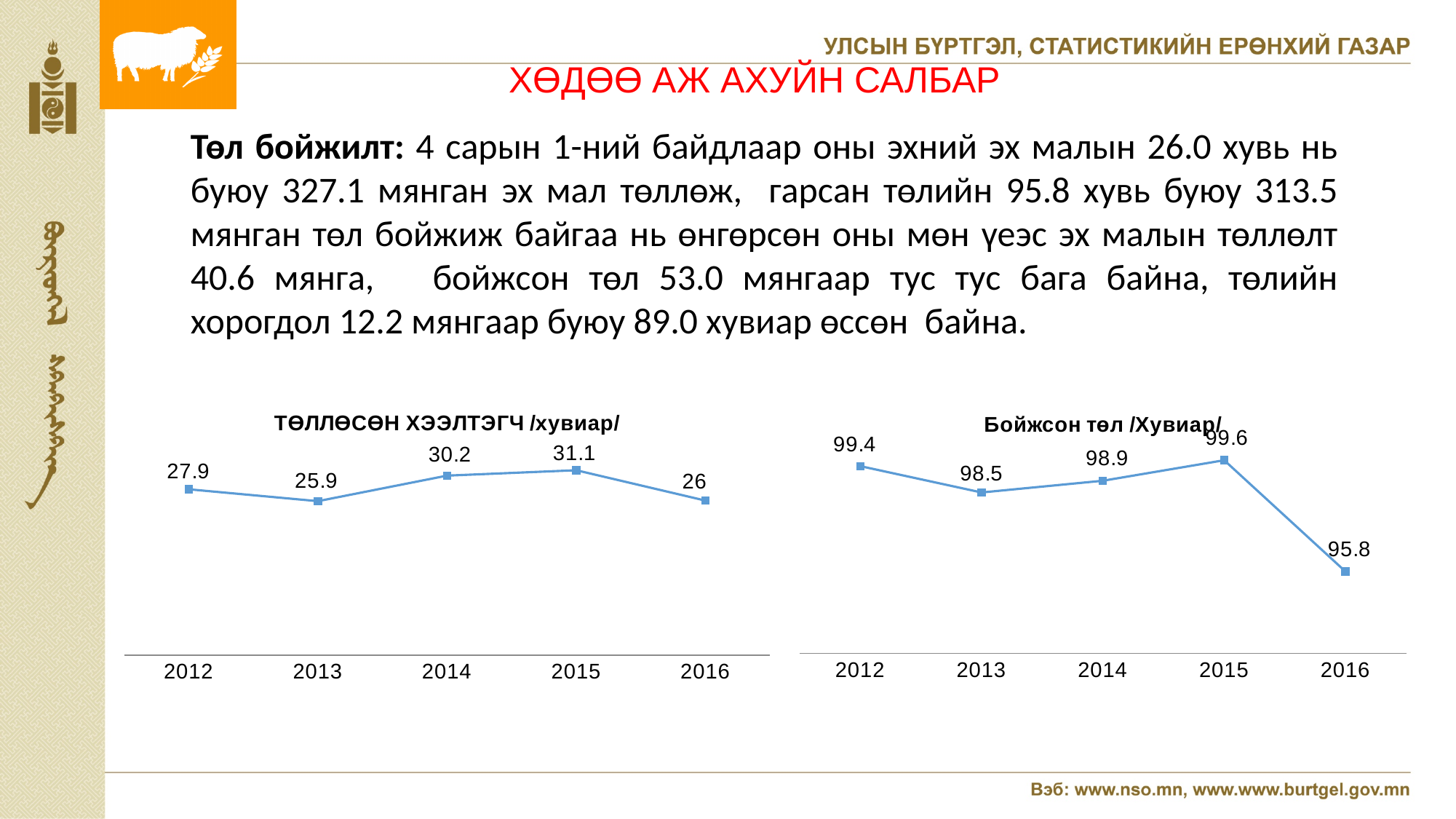
In the left chart (ТӨЛЛӨСӨН ХЭЭЛТЭГЧ /хувиар/), what is the difference between the 2015 and 2013 values? 5.2 In the right chart (Бойжсон төл /Хувиар/), is the value for 2012 larger or smaller than the value for 2014? larger In the left chart (ТӨЛЛӨСӨН ХЭЭЛТЭГЧ /хувиар/), which year has the highest value? 2015 In the left chart (ТӨЛЛӨСӨН ХЭЭЛТЭГЧ /хувиар/), what is the value for 2014? 30.2 In the right chart (Бойжсон төл /Хувиар/), what is the value for 2016? 95.8 In the right chart (Бойжсон төл /Хувиар/), what is the difference between the 2015 and 2016 values? 3.8 In the right chart (Бойжсон төл /Хувиар/), which year has the lowest value? 2016 What kind of chart is the left chart (ТӨЛЛӨСӨН ХЭЭЛТЭГЧ /хувиар/)? line chart In the right chart (Бойжсон төл /Хувиар/), what is the value for 2013? 98.5 In the right chart (Бойжсон төл /Хувиар/), which year has the highest value? 2015 In the left chart (ТӨЛЛӨСӨН ХЭЭЛТЭГЧ /хувиар/), what is the value for 2016? 26 In the left chart (ТӨЛЛӨСӨН ХЭЭЛТЭГЧ /хувиар/), which year has the lowest value? 2013